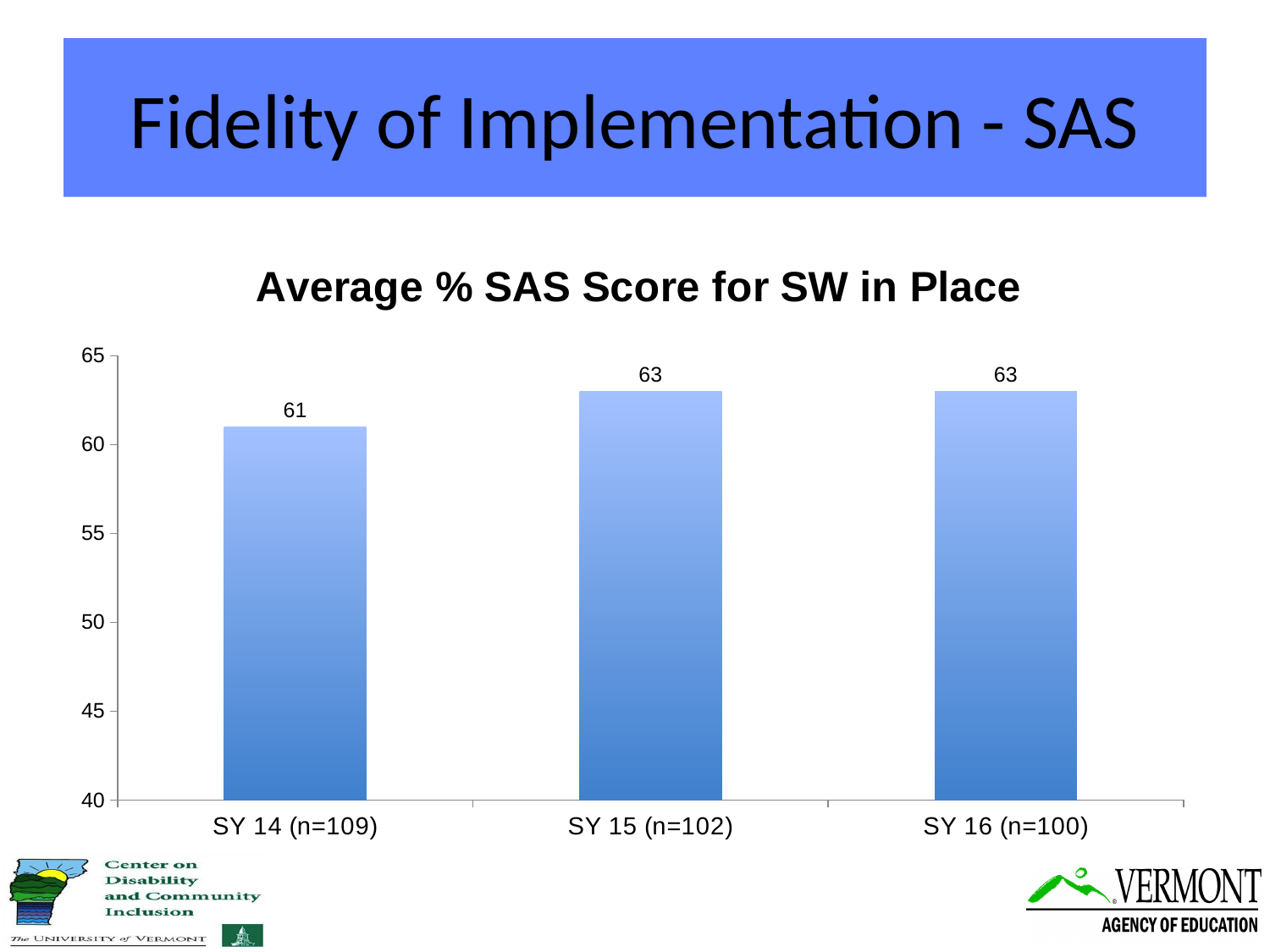
What is the value for SY 16 (n=100)? 63 Do the values rise or fall from SY 14 to SY 15? rise What is the difference between the values for SY 15 (n=102) and SY 14 (n=109)? 2 Is the value for SY 15 (n=102) greater or less than 65? less Which is larger, the value for SY 14 (n=109) or SY 16 (n=100)? SY 16 (n=100) How many categories are shown on the x axis? 3 Is the value for SY 14 (n=109) greater or less than 60? greater What is the title of the chart? Average % SAS Score for SW in Place What kind of chart is shown on the slide? bar chart Which category has the lowest value? SY 14 (n=109) What is the value for SY 14 (n=109)? 61 What is the value for SY 15 (n=102)? 63